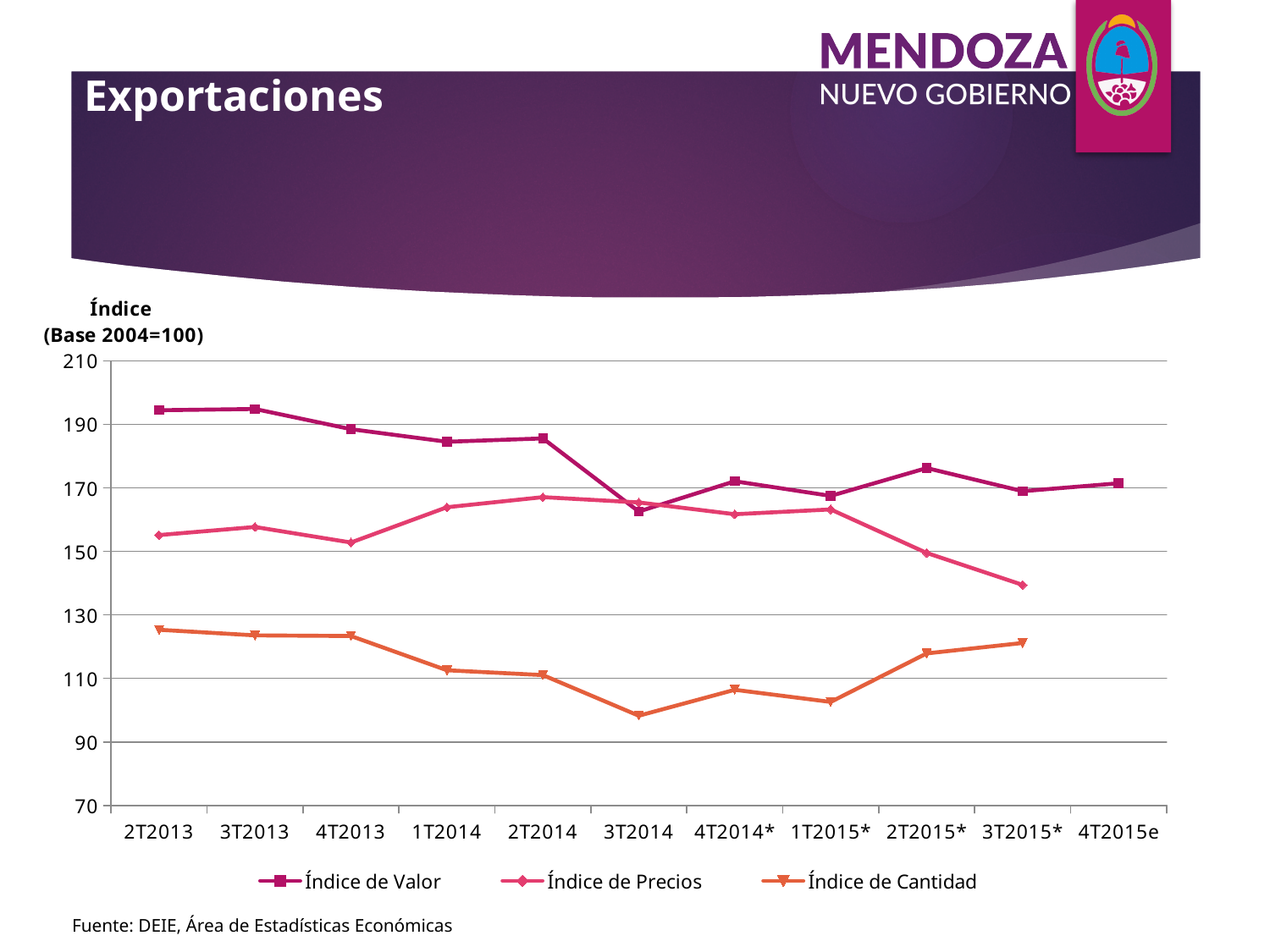
What kind of chart is shown on the slide? line chart Does Índice de Precios rise or fall from 2T2014 to 3T2015*? fall At 2T2013, which is larger: Índice de Valor or Índice de Cantidad? Índice de Valor Is the value of Índice de Cantidad at 3T2014 greater or less than 110? less What is the y-axis label of the chart? Índice (Base 2004=100) Is the value of Índice de Valor at 3T2014 greater or less than 170? less In which period is Índice de Precios at its lowest? 3T2015* Is the value of Índice de Valor at 2T2013 greater or less than 190? greater How many periods are shown on the x axis? 11 In which period is Índice de Cantidad at its lowest? 3T2014 How many series does the legend list? 3